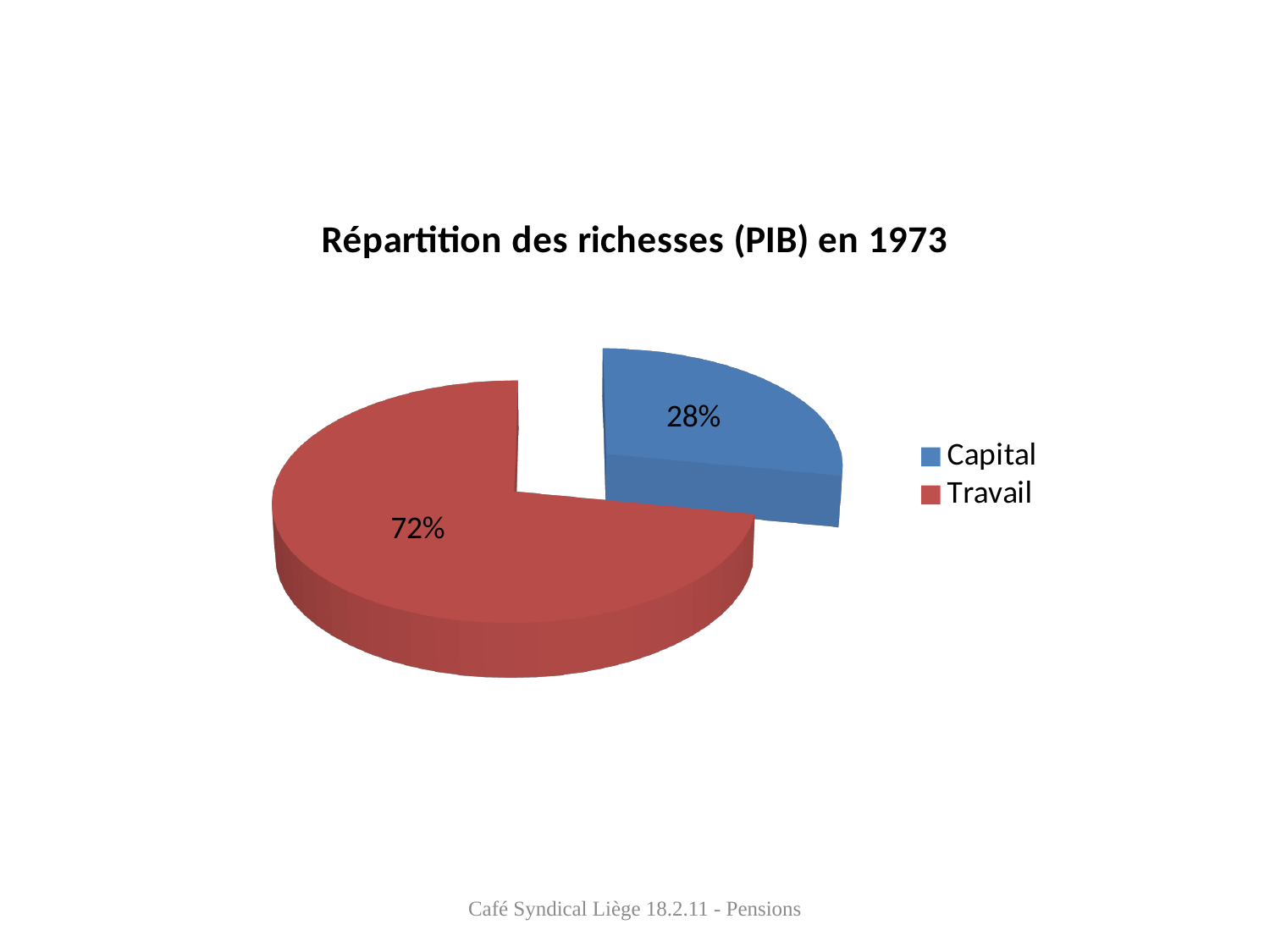
Which category has the smallest slice of the pie? Capital What share of the pie does Capital represent? 28% What colour is the Travail slice? Red How many slices does the pie chart have? 2 What share of the pie does Travail represent? 72% What kind of chart is shown on the slide? Pie chart How many entries does the legend list? 2 Which is larger, the Capital slice or the Travail slice? Travail What is the difference in percentage points between the Travail and Capital slices? 44 What is the title of the chart? Répartition des richesses (PIB) en 1973 Which category has the largest slice of the pie? Travail